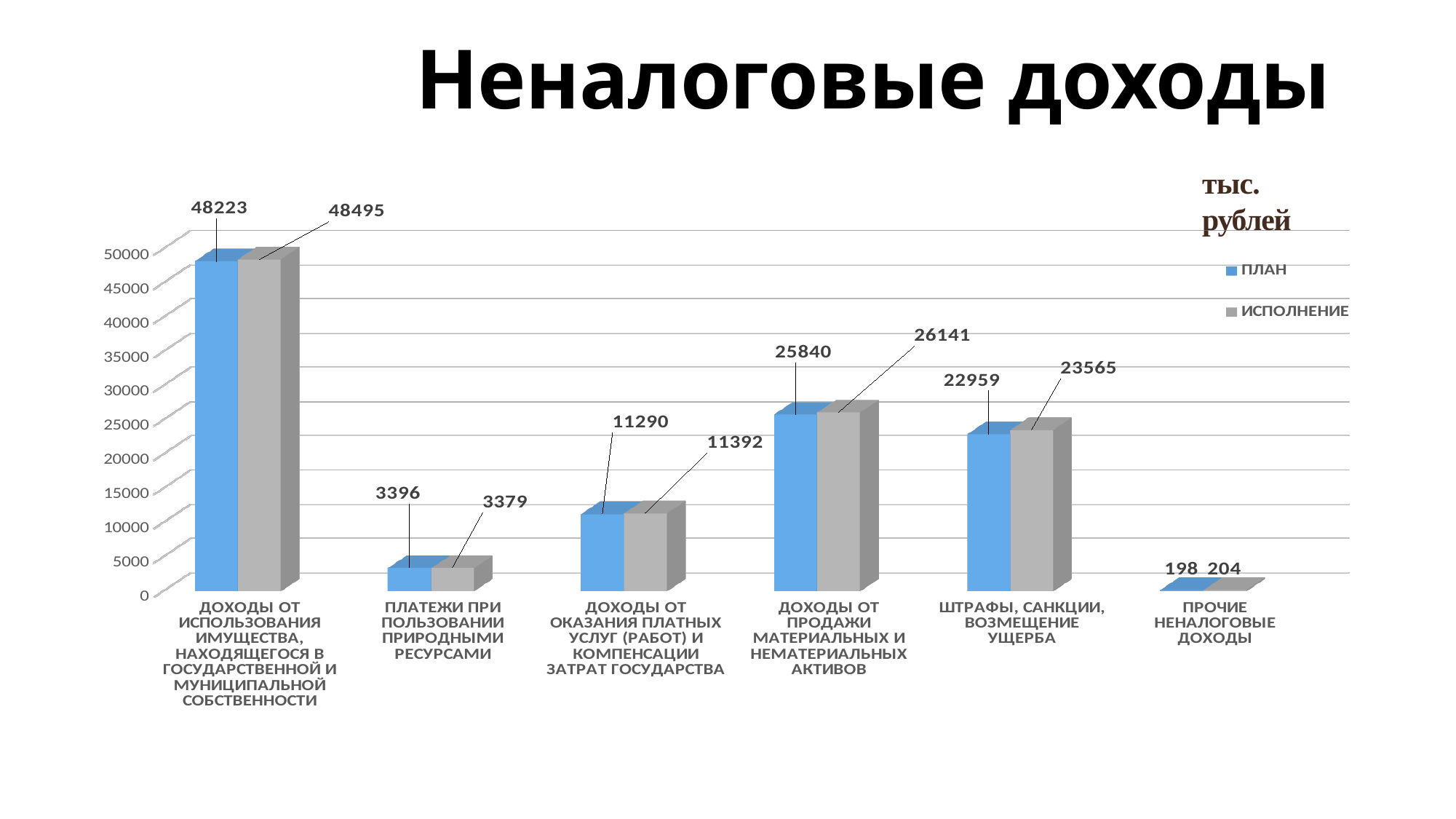
What type of chart is shown on the slide? Bar chart What is the ПЛАН value for ПЛАТЕЖИ ПРИ ПОЛЬЗОВАНИИ ПРИРОДНЫМИ РЕСУРСАМИ? 3396 Which category has the highest ИСПОЛНЕНИЕ value? ДОХОДЫ ОТ ИСПОЛЬЗОВАНИЯ ИМУЩЕСТВА, НАХОДЯЩЕГОСЯ В ГОСУДАРСТВЕННОЙ И МУНИЦИПАЛЬНОЙ СОБСТВЕННОСТИ How many categories are shown on the x axis? 6 What is the difference between the ИСПОЛНЕНИЕ and ПЛАН values for ШТРАФЫ, САНКЦИИ, ВОЗМЕЩЕНИЕ УЩЕРБА? 606 How many series does the legend list? 2 What is the ИСПОЛНЕНИЕ value for ДОХОДЫ ОТ ПРОДАЖИ МАТЕРИАЛЬНЫХ И НЕМАТЕРИАЛЬНЫХ АКТИВОВ? 26141 Which category has the lowest ПЛАН value? ПРОЧИЕ НЕНАЛОГОВЫЕ ДОХОДЫ For ПЛАТЕЖИ ПРИ ПОЛЬЗОВАНИИ ПРИРОДНЫМИ РЕСУРСАМИ, which is larger: ПЛАН or ИСПОЛНЕНИЕ? ПЛАН What is the difference between the ПЛАН and ИСПОЛНЕНИЕ values for ДОХОДЫ ОТ ИСПОЛЬЗОВАНИЯ ИМУЩЕСТВА, НАХОДЯЩЕГОСЯ В ГОСУДАРСТВЕННОЙ И МУНИЦИПАЛЬНОЙ СОБСТВЕННОСТИ? 272 What is the ПЛАН value for ШТРАФЫ, САНКЦИИ, ВОЗМЕЩЕНИЕ УЩЕРБА? 22959 What is the ИСПОЛНЕНИЕ value for ПРОЧИЕ НЕНАЛОГОВЫЕ ДОХОДЫ? 204